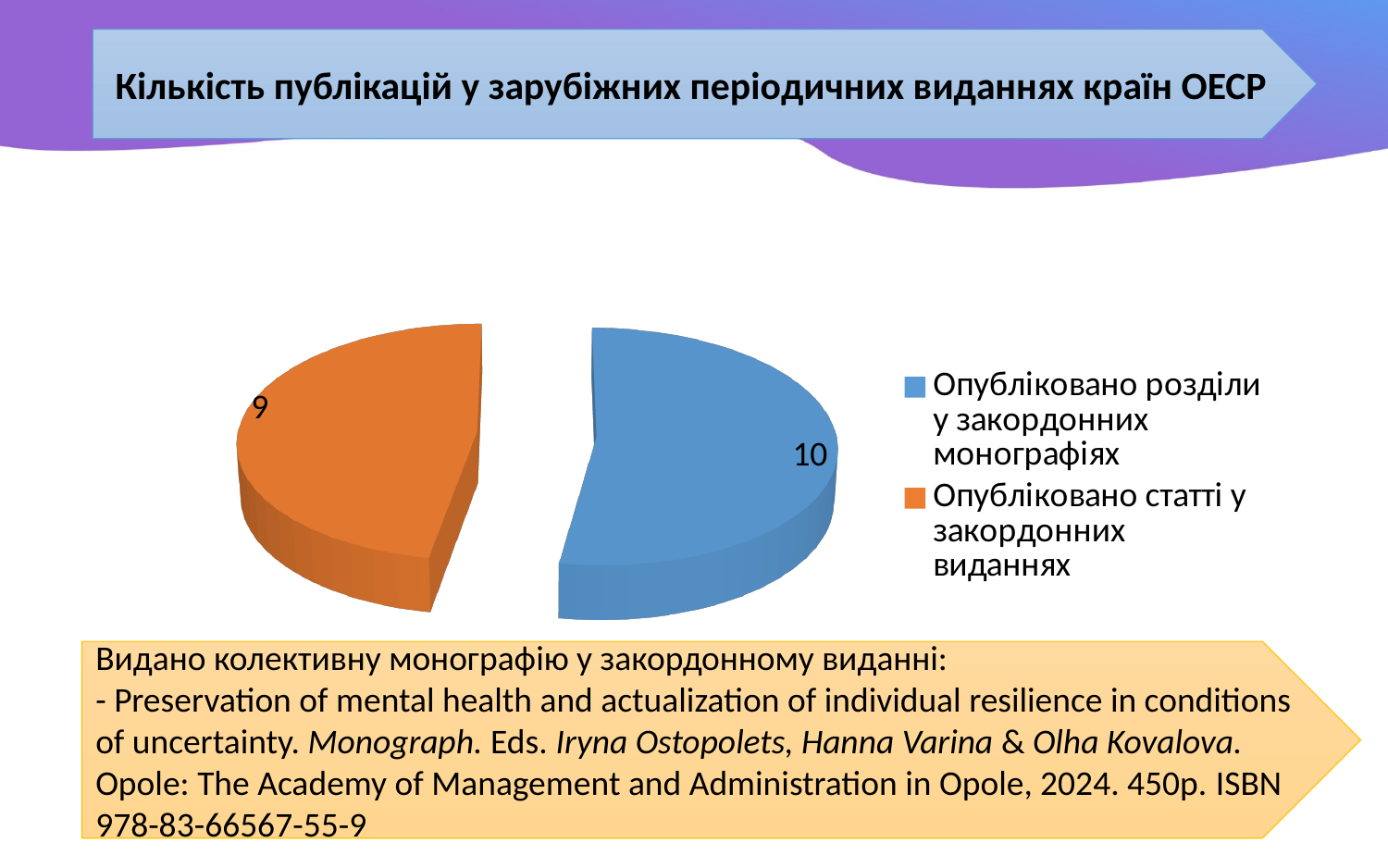
What is the value for "Опубліковано статті у закордонних виданнях"? 9 How many entries does the legend list? 2 Which is larger: the value for "Опубліковано розділи у закордонних монографіях" or the value for "Опубліковано статті у закордонних виданнях"? Опубліковано розділи у закордонних монографіях How many slices does the pie chart have? 2 What is the title of the slide containing the chart? Кількість публікацій у зарубіжних періодичних виданнях країн ОЕСР What is the total of all slices in the pie chart? 19 What is the difference between the value for "Опубліковано розділи у закордонних монографіях" and the value for "Опубліковано статті у закордонних виданнях"? 1 Which category has the smallest slice of the pie? Опубліковано статті у закордонних виданнях What is the value for "Опубліковано розділи у закордонних монографіях"? 10 Which category has the largest slice of the pie? Опубліковано розділи у закордонних монографіях What colour is the slice for "Опубліковано статті у закордонних виданнях"? orange What type of chart is shown on the slide? pie chart